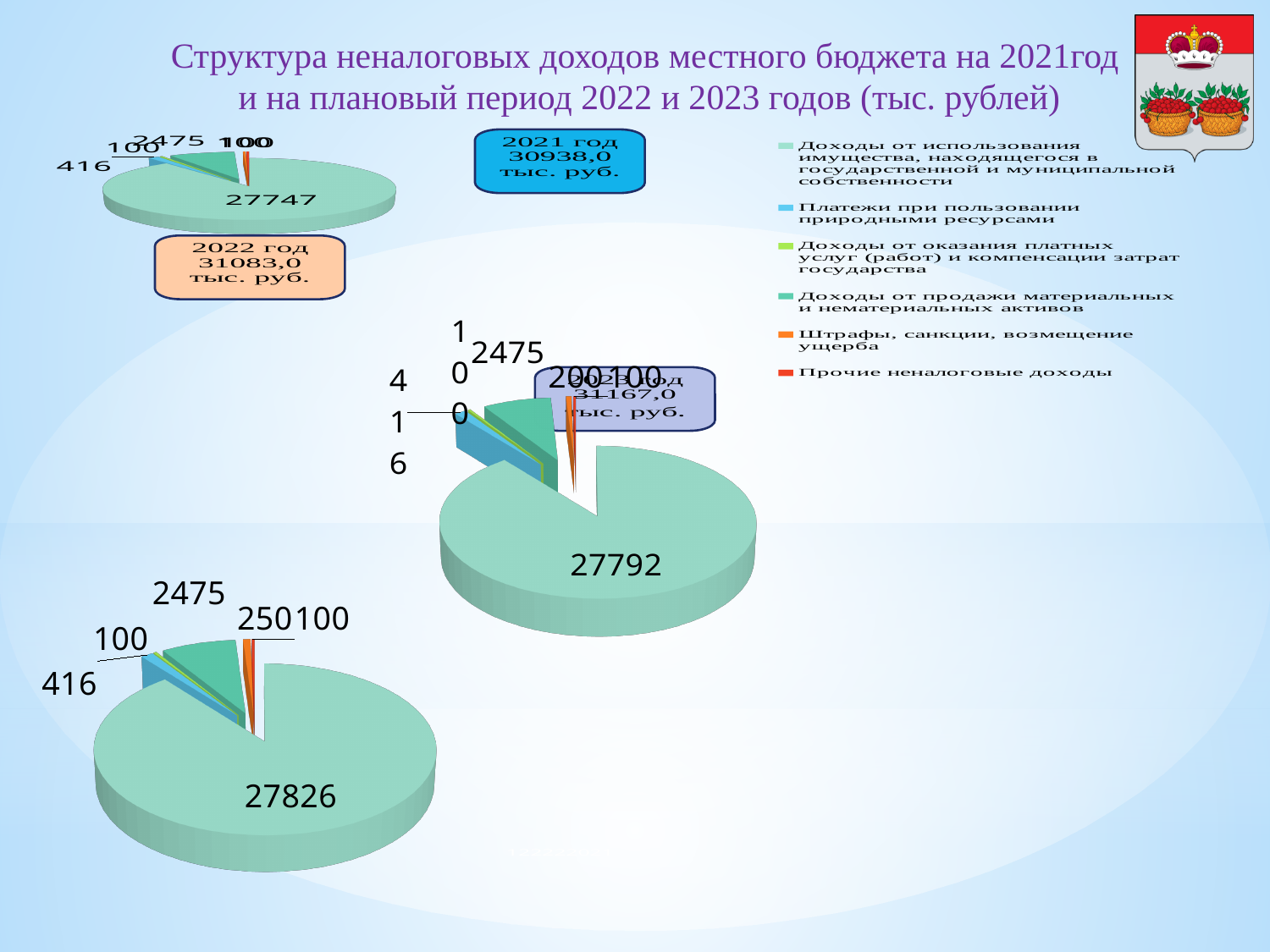
In the bottom-left pie chart, which is larger: the slice labelled 2475 or the slice labelled 416? 2475 In the bottom-left pie chart, what is the value of the blue slice (Платежи при пользовании природными ресурсами)? 416 What is the difference between the largest slice of the bottom-left pie chart (27826) and the largest slice of the middle pie chart (27792)? 34 What kind of charts are shown on the slide? Pie charts What total is shown in the box labelled 2021 год? 30938,0 тыс. руб. How many pie charts are on the slide? 3 How many entries does the legend on the right list? 6 In the bottom-left pie chart, what is the value of the largest slice? 27826 In the middle pie chart, what is the value of the orange slice (Штрафы, санкции, возмещение ущерба)? 200 In the bottom-left pie chart, what is the value of the orange slice (Штрафы, санкции, возмещение ущерба)? 250 In the middle pie chart, what is the value of the largest slice? 27792 In the top-left pie chart, what is the value of the largest slice? 27747